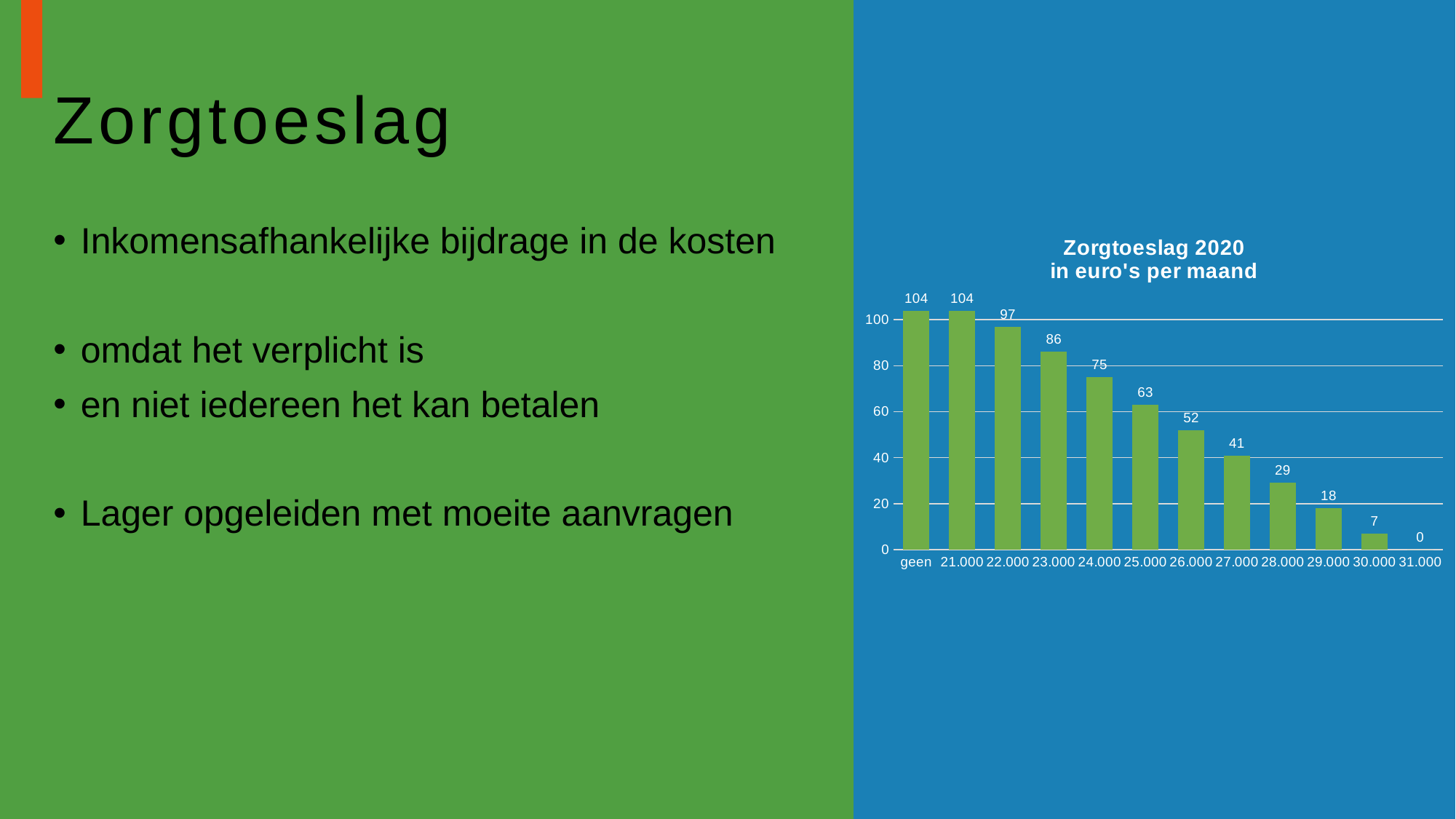
What is the value for 30.000 in the Zorgtoeslag 2020 chart? 7 What is the value for 'geen' in the Zorgtoeslag 2020 chart? 104 What is the difference between the values for 24.000 and 25.000 in the Zorgtoeslag 2020 chart? 12 What is the value for 27.000 in the Zorgtoeslag 2020 chart? 41 What is the title of the chart on the slide? Zorgtoeslag 2020 in euro's per maand How many categories are shown on the x axis of the Zorgtoeslag 2020 chart? 12 Which is larger in the Zorgtoeslag 2020 chart: the value for 26.000 or the value for 28.000? 26.000 What kind of chart is the Zorgtoeslag 2020 chart? bar chart What is the value for 23.000 in the Zorgtoeslag 2020 chart? 86 What is the difference between the values for 22.000 and 29.000 in the Zorgtoeslag 2020 chart? 79 Do the values in the Zorgtoeslag 2020 chart rise or fall from left to right along the x axis? fall Which category has the lowest value in the Zorgtoeslag 2020 chart? 31.000